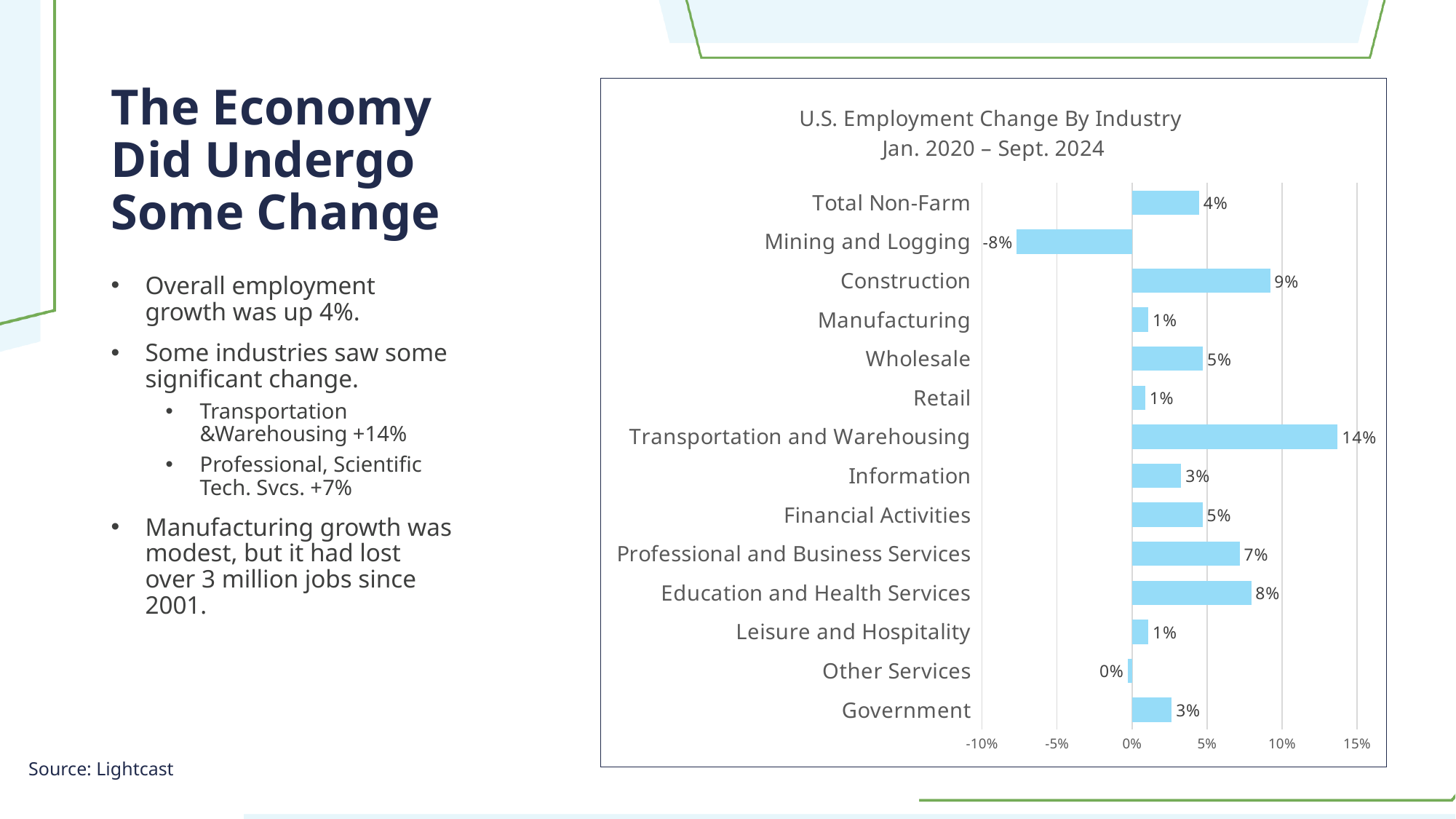
How many industry categories are shown in the chart? 14 What is the employment change for Government? 3% What kind of chart is shown on the slide? Bar chart What is the employment change for Education and Health Services? 8% Which has a larger employment change, Professional and Business Services or Information? Professional and Business Services Which industry has the highest employment change? Transportation and Warehousing Which industry has the lowest employment change? Mining and Logging What is the difference between the employment change for Construction and for Manufacturing? 8% Is the value for Construction greater or less than 5%? greater What is the title of the chart? U.S. Employment Change By Industry Jan. 2020 – Sept. 2024 What is the employment change for Mining and Logging? -8% What is the employment change for Transportation and Warehousing? 14%